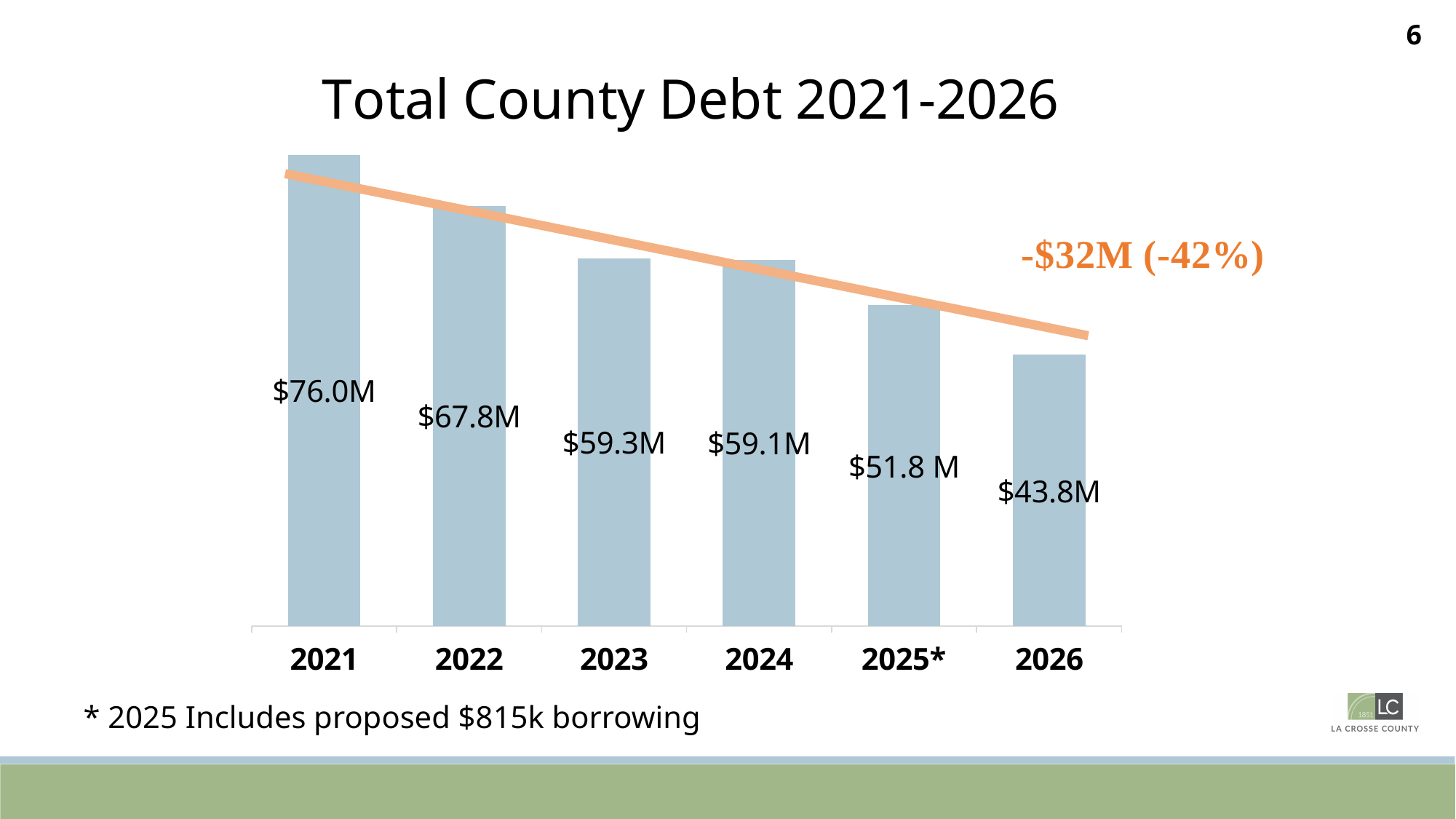
Which is larger, the debt for 2022 or the debt for 2023? 2022 What is the total county debt shown for 2026? $43.8M How many years are shown on the x axis of the chart? 6 What is the total county debt shown for 2024? $59.1M What is the total county debt shown for 2025*? $51.8 M What overall change is annotated in orange on the chart? -$32M (-42%) What is the difference between the 2021 debt and the 2022 debt? $8.2M What kind of chart is shown on the slide? Bar chart Which year has the lowest total county debt? 2026 What is the total county debt shown for 2021? $76.0M Do the debt values rise or fall from 2021 to 2026? Fall Which year has the highest total county debt? 2021